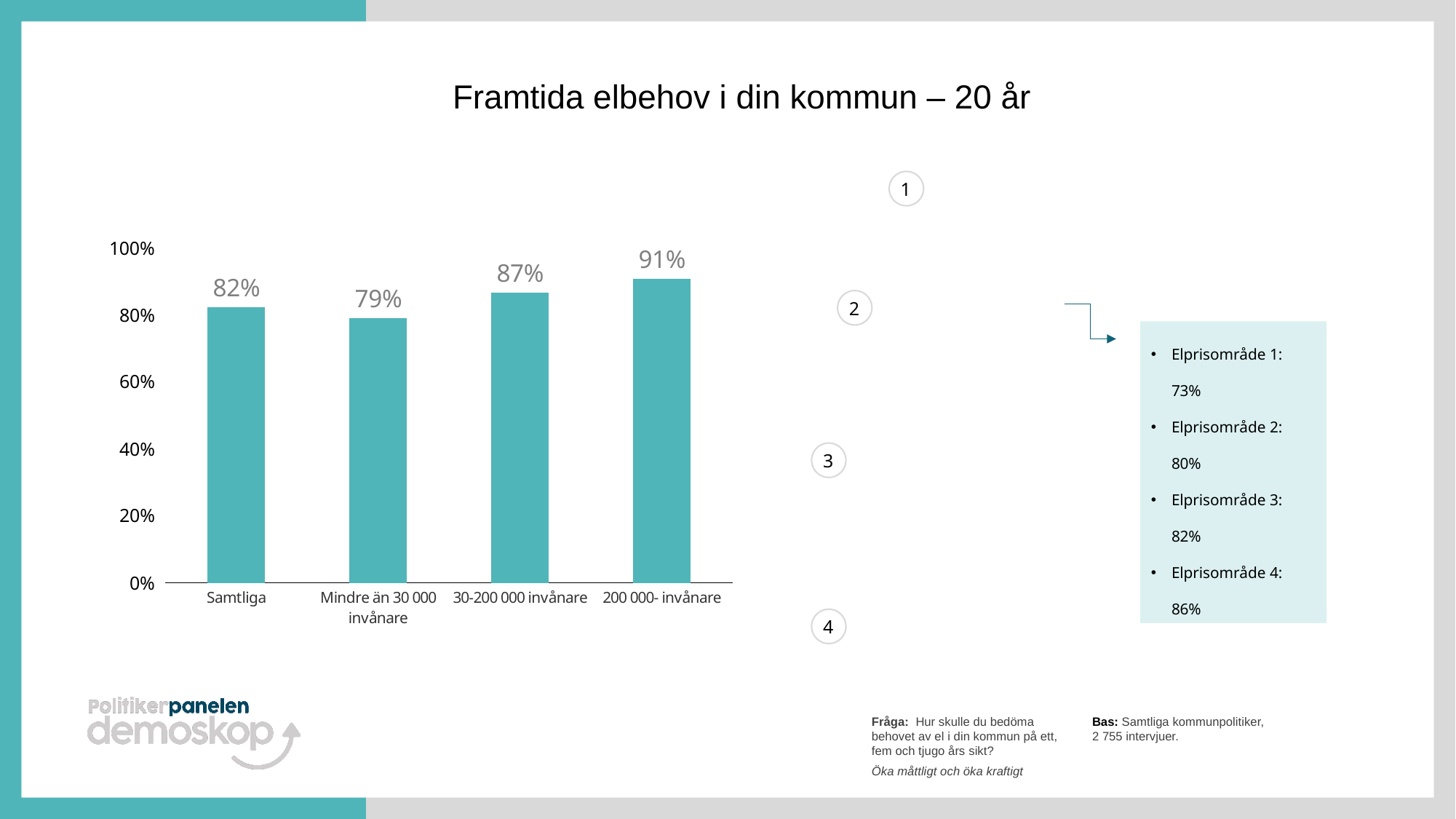
What is the value for Samtliga? 82% What is the value for 200 000- invånare? 91% What is the value for 30-200 000 invånare? 87% What is the value for Mindre än 30 000 invånare? 79% What is the title of the chart? Framtida elbehov i din kommun – 20 år How many categories are shown on the x axis of the bar chart? 4 Which category has the highest value? 200 000- invånare Is the value for Mindre än 30 000 invånare greater or less than 80%? less Which is larger, the value for Samtliga or the value for 30-200 000 invånare? 30-200 000 invånare What is the difference between the values for 200 000- invånare and Mindre än 30 000 invånare? 12% Which category has the lowest value? Mindre än 30 000 invånare What kind of chart is shown on the slide? bar chart